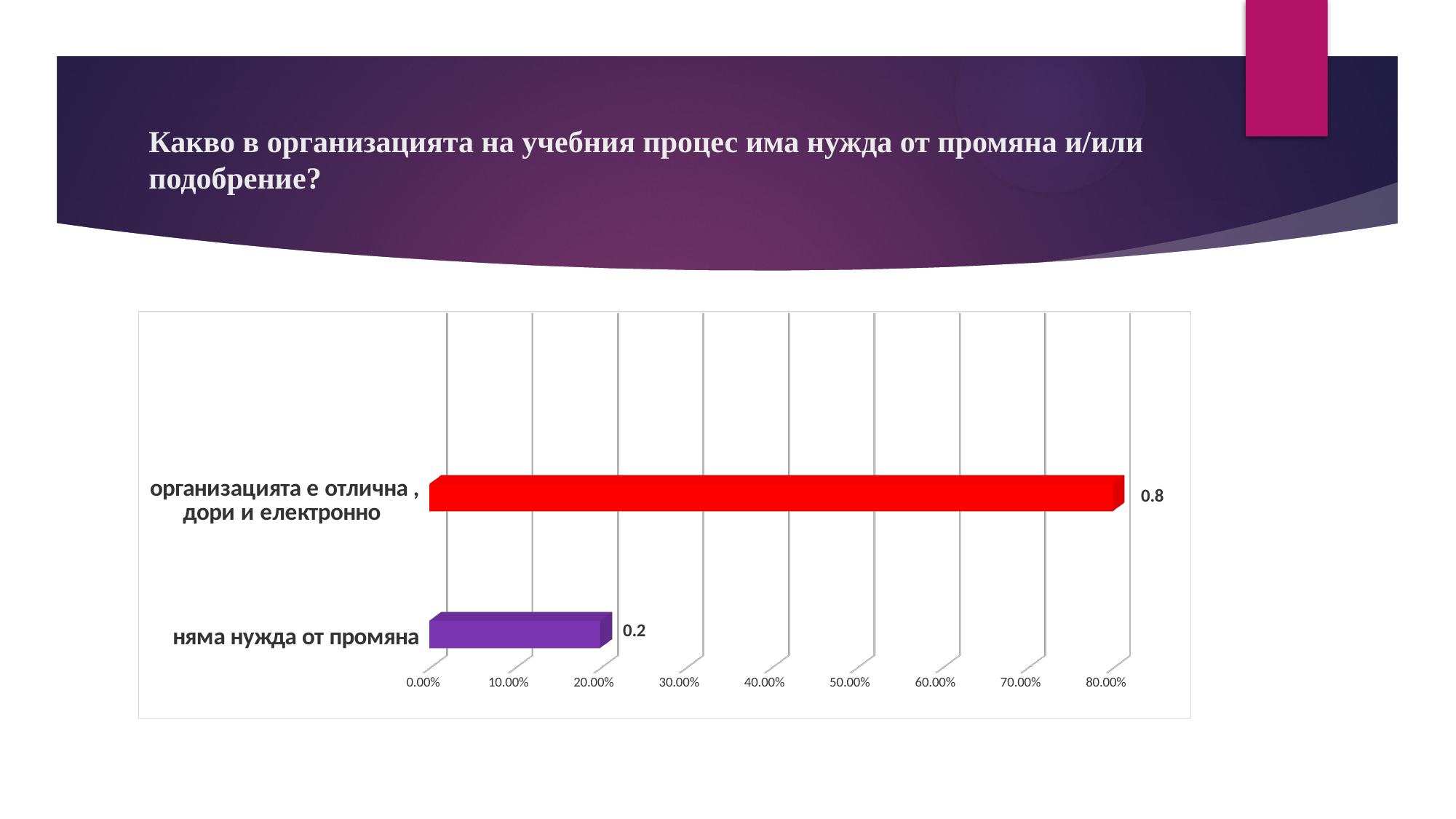
Is the value for 'организацията е отлична , дори и електронно' greater or less than 50.00%? greater What kind of chart is shown on the slide? bar chart Which category has the highest value? организацията е отлична , дори и електронно What is the data label shown for the bar 'организацията е отлична , дори и електронно'? 0.8 Which is larger: the value for 'организацията е отлична , дори и електронно' or for 'няма нужда от промяна'? организацията е отлична , дори и електронно How many categories are shown in the chart? 2 Is the value for 'няма нужда от промяна' greater or less than 30.00%? less What is the difference between the data labels for 'организацията е отлична , дори и електронно' and 'няма нужда от промяна'? 0.6 Which category has the lowest value? няма нужда от промяна What is the data label shown for the bar 'няма нужда от промяна'? 0.2 What is the highest tick label shown on the horizontal axis? 80.00% What colour is the bar for 'няма нужда от промяна'? purple